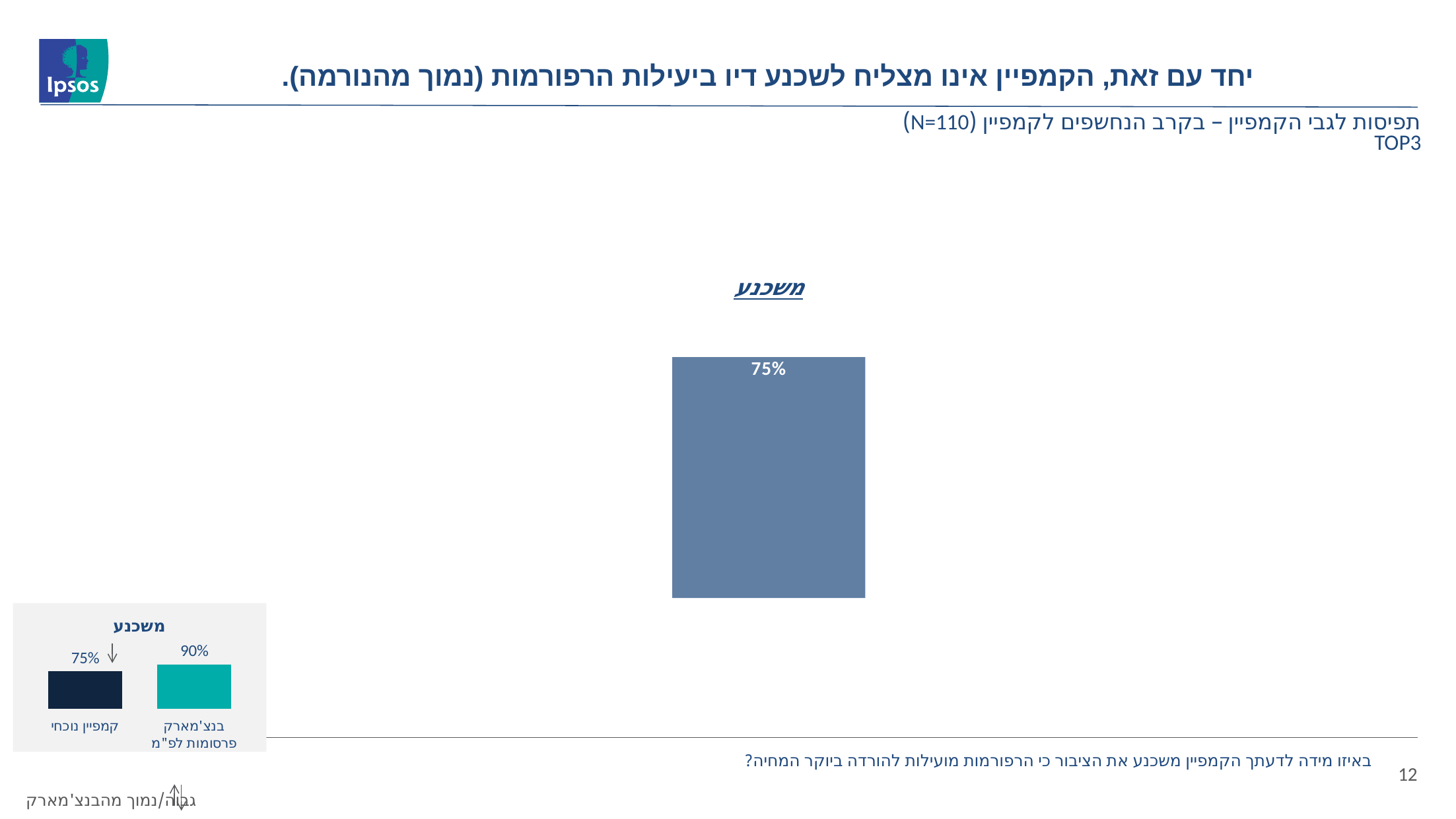
In the small chart at the bottom left, which category has the higher value? בנצ'מארק פרסומות לפ"מ In the small chart at the bottom left, what value is shown for קמפיין נוכחי? 75% In the small chart at the bottom left, what value is shown for בנצ'מארק פרסומות לפ"מ? 90% In the small chart at the bottom left, is the value for קמפיין נוכחי larger or smaller than the value for בנצ'מארק פרסומות לפ"מ? smaller How many bars does the small chart at the bottom left show? 2 What kind of chart is the main chart in the centre of the slide? bar chart In the small chart at the bottom left, which category has the lower value? קמפיין נוכחי How many bars does the main chart in the centre of the slide show? 1 What is the title of the main chart in the centre of the slide? משכנע In the small chart at the bottom left, what is the difference between the value for בנצ'מארק פרסומות לפ"מ and the value for קמפיין נוכחי? 15% In the main chart titled משכנע, what value is shown for the bar? 75% What is the title of the small chart at the bottom left? משכנע